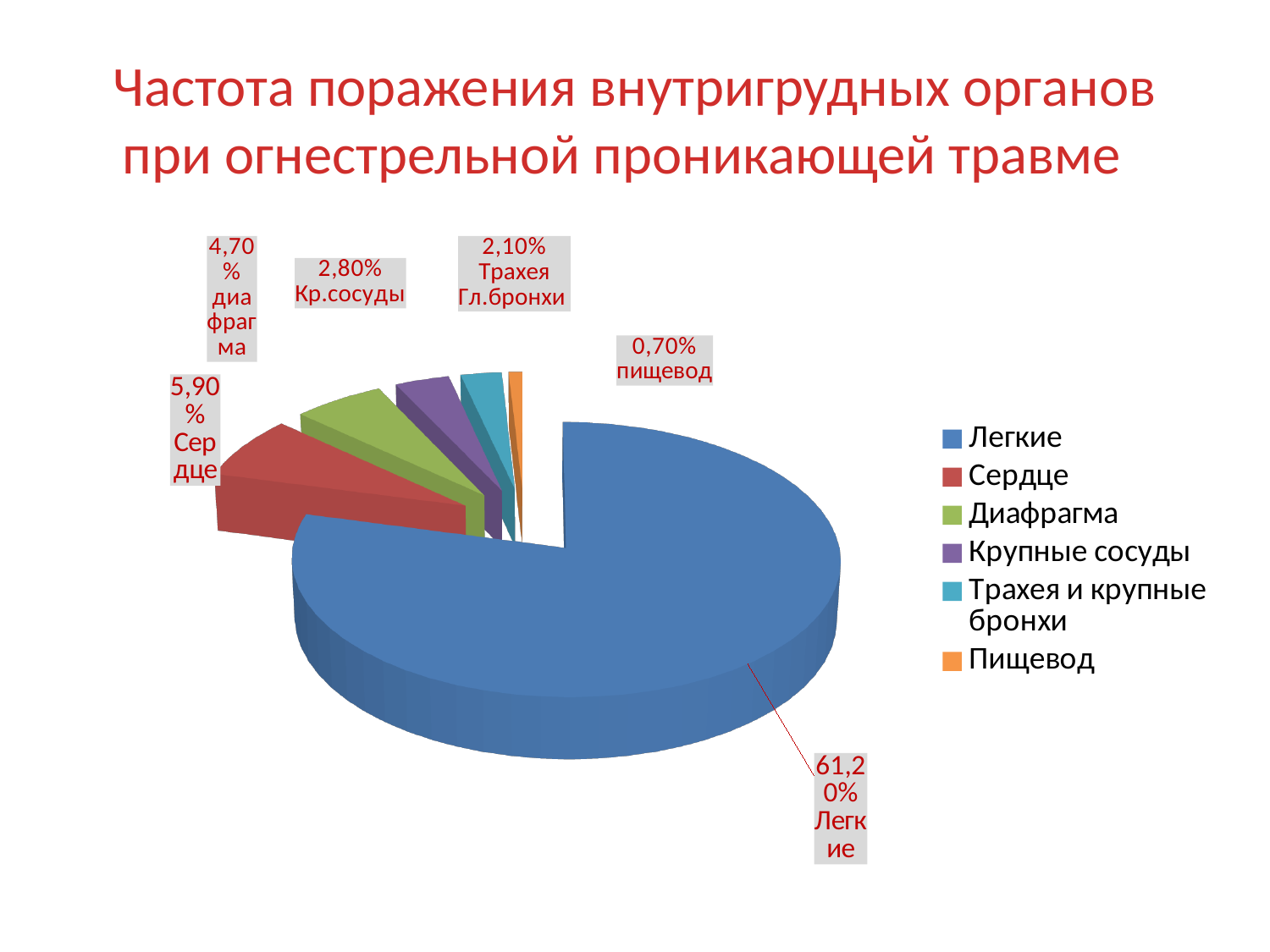
What percentage is shown for Сердце? 5,90% What percentage is shown for Кр.сосуды (Крупные сосуды)? 2,80% What percentage is shown for Трахея и крупные бронхи? 2,10% How many categories does the legend list? 6 What type of chart is shown on the slide? Pie chart What percentage is shown for Диафрагма? 4,70% Which is larger, the value for Сердце or the value for Диафрагма? Сердце What is the difference between the percentages for Сердце and Диафрагма? 1,20% Which category has the smallest slice of the pie? Пищевод Which category has the largest slice of the pie? Легкие What percentage is shown for Пищевод? 0,70% What percentage is shown for Легкие? 61,20%